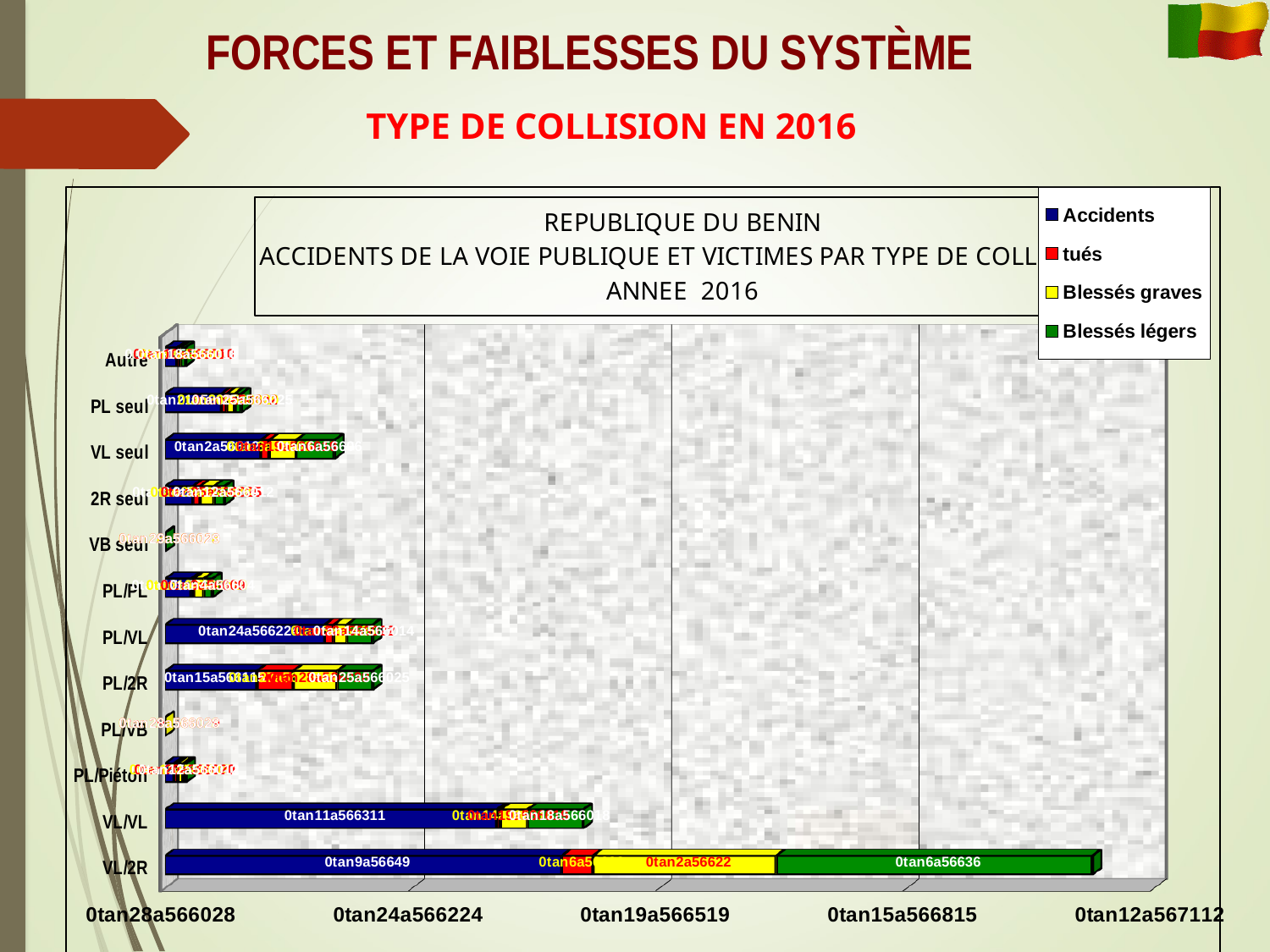
Which has the longer total bar, PL/2R or PL/PL? PL/2R How many series does the legend list? 4 What kind of chart is shown on the slide? Stacked bar chart Which has the longer total bar, VL/2R or VL/VL? VL/2R Which colour represents the 'Accidents' series in the legend? Blue Which collision type has the longest total bar? VL/2R What is the name of the series shown in red in the legend? tués Which has the longer total bar, VL/VL or PL/VL? VL/VL How many collision-type categories are plotted on the vertical axis? 12